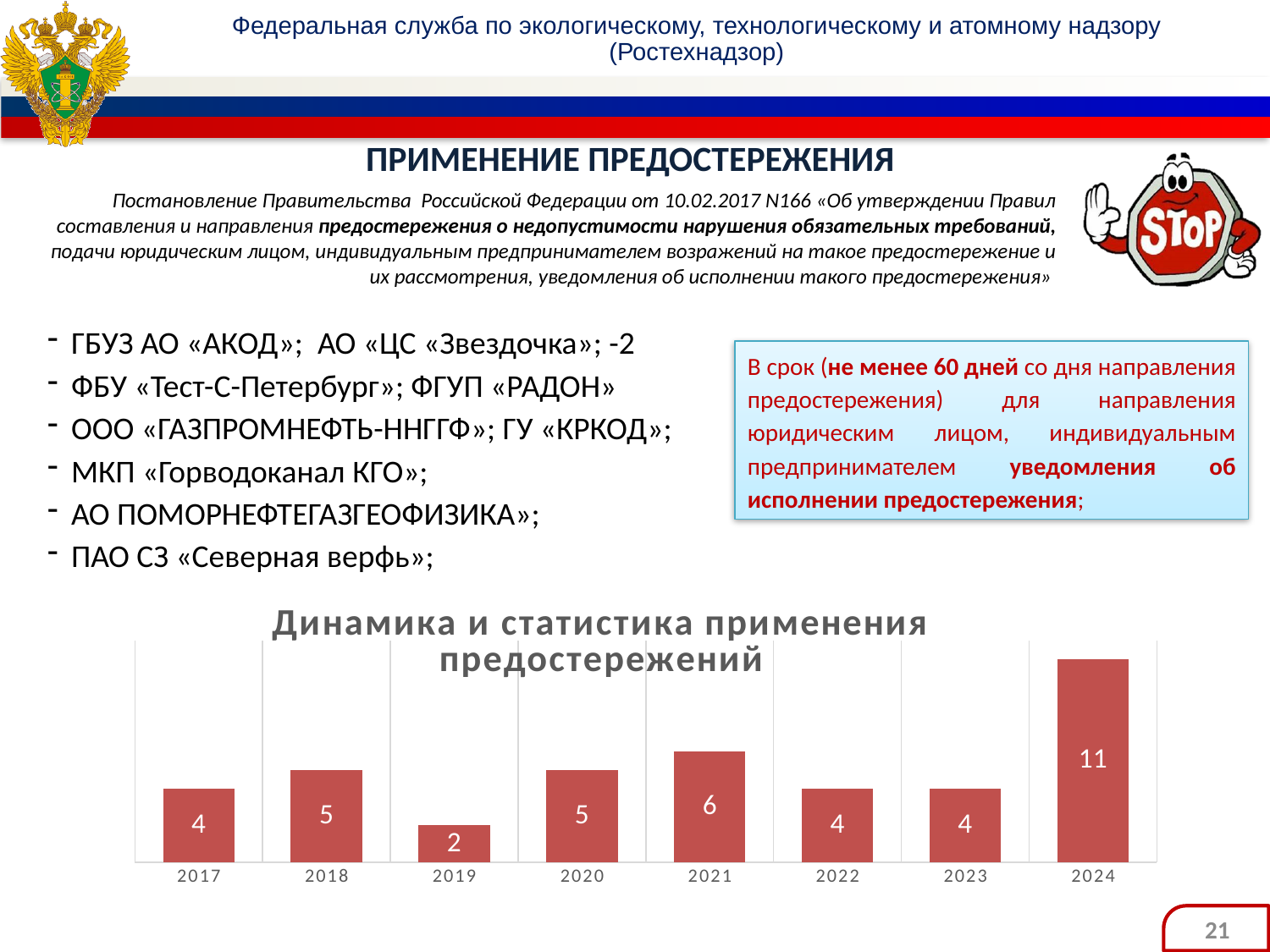
What is the value for 2019 in the chart? 2 What kind of chart is shown on the slide? bar chart Which year has the lowest value in the chart? 2019 Which is larger, the value for 2018 or the value for 2019? 2018 What is the difference between the values for 2024 and 2023? 7 What is the value for 2024 in the chart? 11 What is the value for 2021 in the chart? 6 Do the values rise or fall from 2023 to 2024? rise Which year has the highest value in the chart? 2024 How many years are shown on the x axis of the chart? 8 What is the title of the chart? Динамика и статистика применения предостережений What is the difference between the values for 2021 and 2019? 4